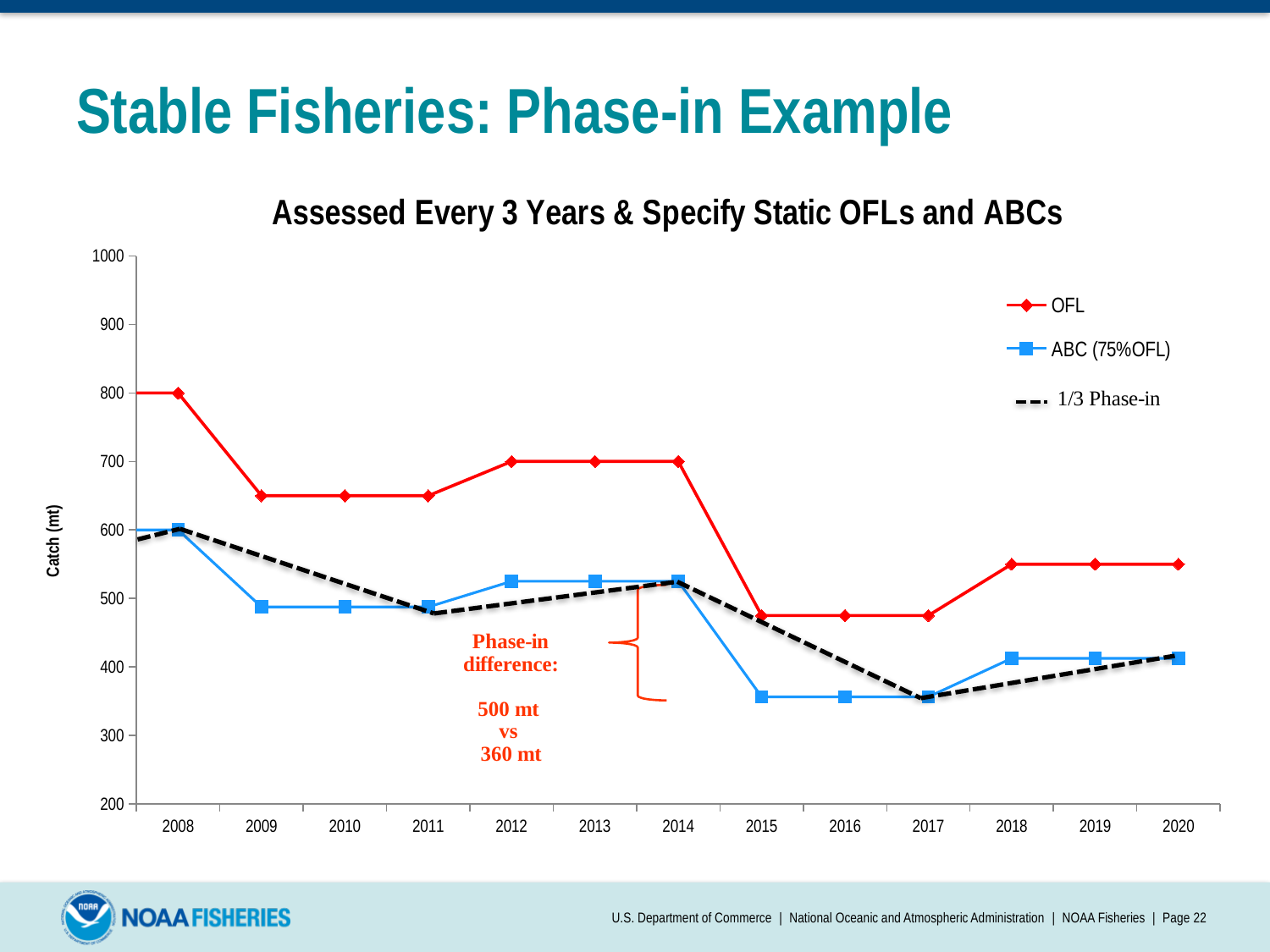
How many years are plotted along the x axis? 13 What is the OFL value in 2013? 700 What is the ABC (75%OFL) value in 2008? 600 How many series does the legend list? 3 What kind of chart is shown on the slide? Line chart Is the OFL value for 2015 greater or less than 500? less What is the label on the y axis? Catch (mt) What is the OFL value in 2008? 800 Does the OFL series rise or fall from 2008 to 2011? Fall Is the ABC (75%OFL) value for 2016 greater or less than 400? less In which year is the OFL series at its highest? 2008 Which series has the larger value in 2014, OFL or ABC (75%OFL)? OFL